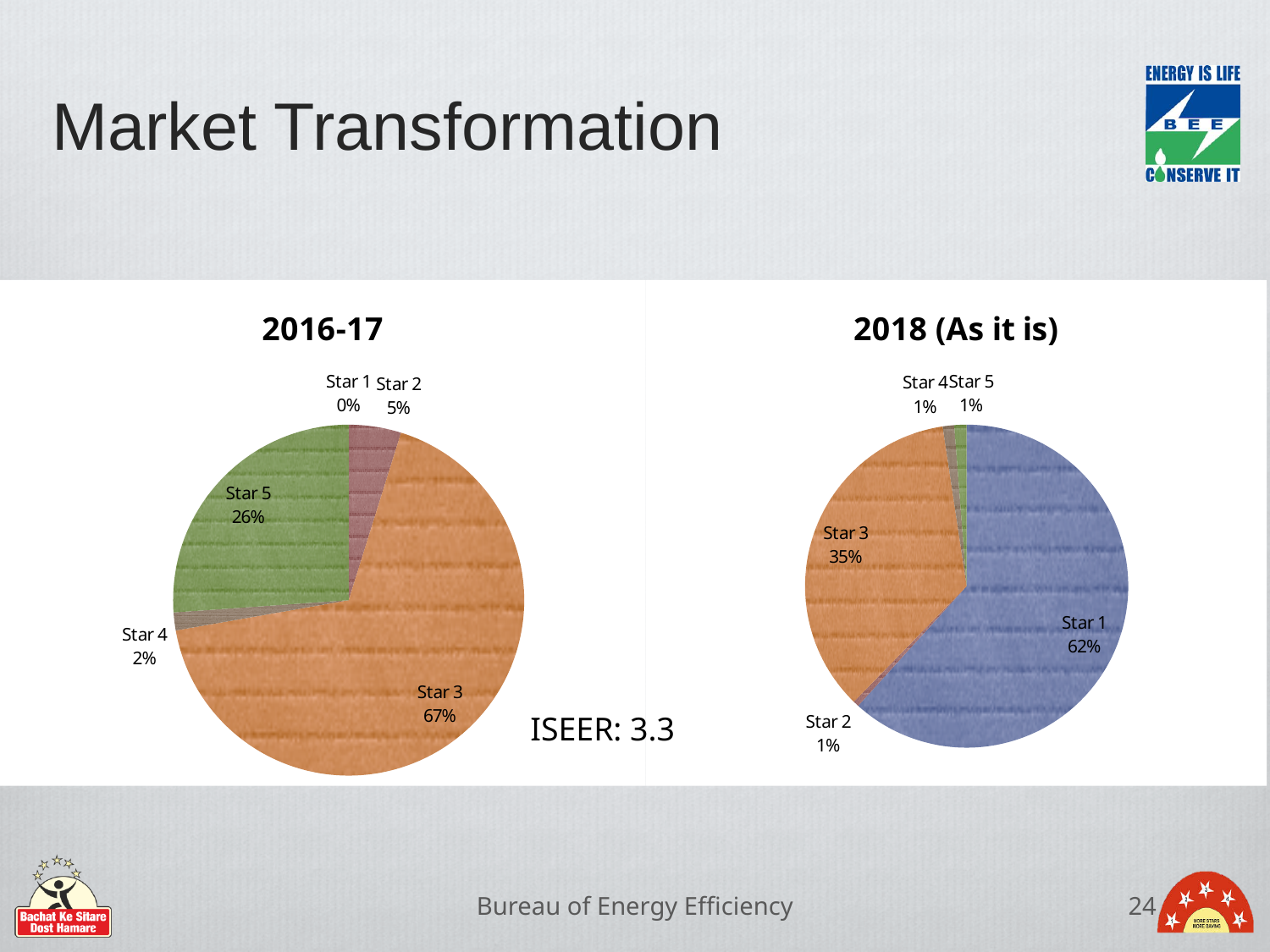
In the 2016-17 pie chart, what share does Star 5 have? 26% What type of chart is used for the 2016-17 data? Pie chart In the 2018 (As it is) pie chart, what share does Star 3 have? 35% In the 2016-17 pie chart, which star rating has the largest share? Star 3 In the 2018 (As it is) pie chart, which star rating has the largest share? Star 1 In the 2018 (As it is) pie chart, what is the difference between the Star 1 share and the Star 3 share? 27% How many slices does the 2018 (As it is) pie chart have? 5 In the 2016-17 pie chart, which star rating has the smallest share? Star 1 In the 2018 (As it is) pie chart, what share does Star 1 have? 62% In the 2016-17 pie chart, what is the difference between the Star 3 share and the Star 5 share? 41% In the 2016-17 pie chart, what share does Star 3 have? 67% In the 2016-17 pie chart, which is larger, the Star 2 share or the Star 4 share? Star 2